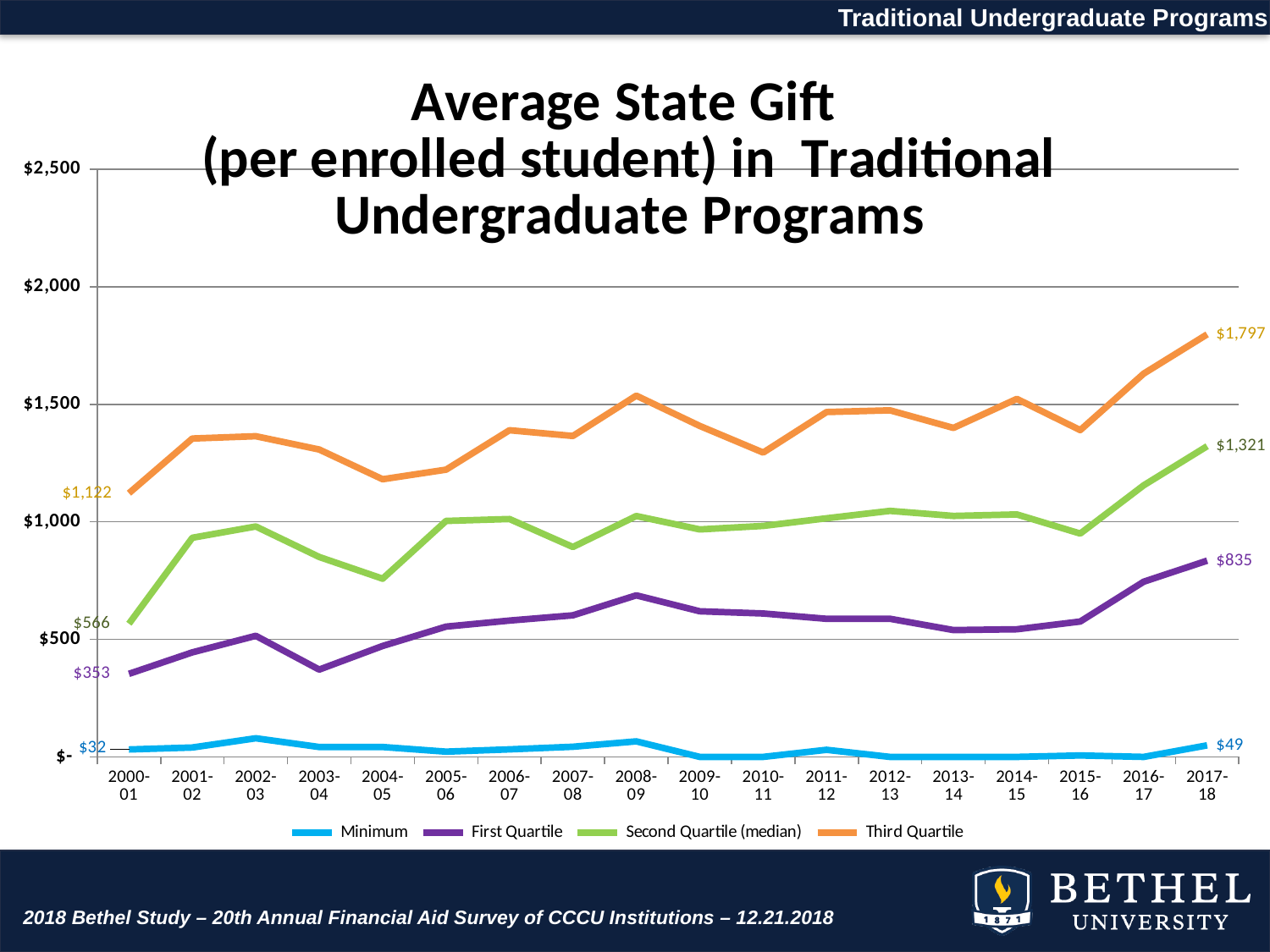
What is the Second Quartile (median) value for 2000-01? $566 Does the First Quartile series generally rise or fall from 2000-01 to 2017-18? rise How many academic years are plotted along the x axis? 18 What is the Third Quartile value for 2017-18? $1,797 Which series has the highest value in 2017-18? Third Quartile How many series does the legend list? 4 What is the First Quartile value for 2017-18? $835 What is the difference between the Second Quartile (median) and First Quartile values in 2017-18? $486 What kind of chart is shown on the slide? line chart What is the Minimum value for 2000-01? $32 Is the Third Quartile value for 2004-05 greater or less than $1,000? greater By how much did the Third Quartile value increase from 2000-01 to 2017-18? $675